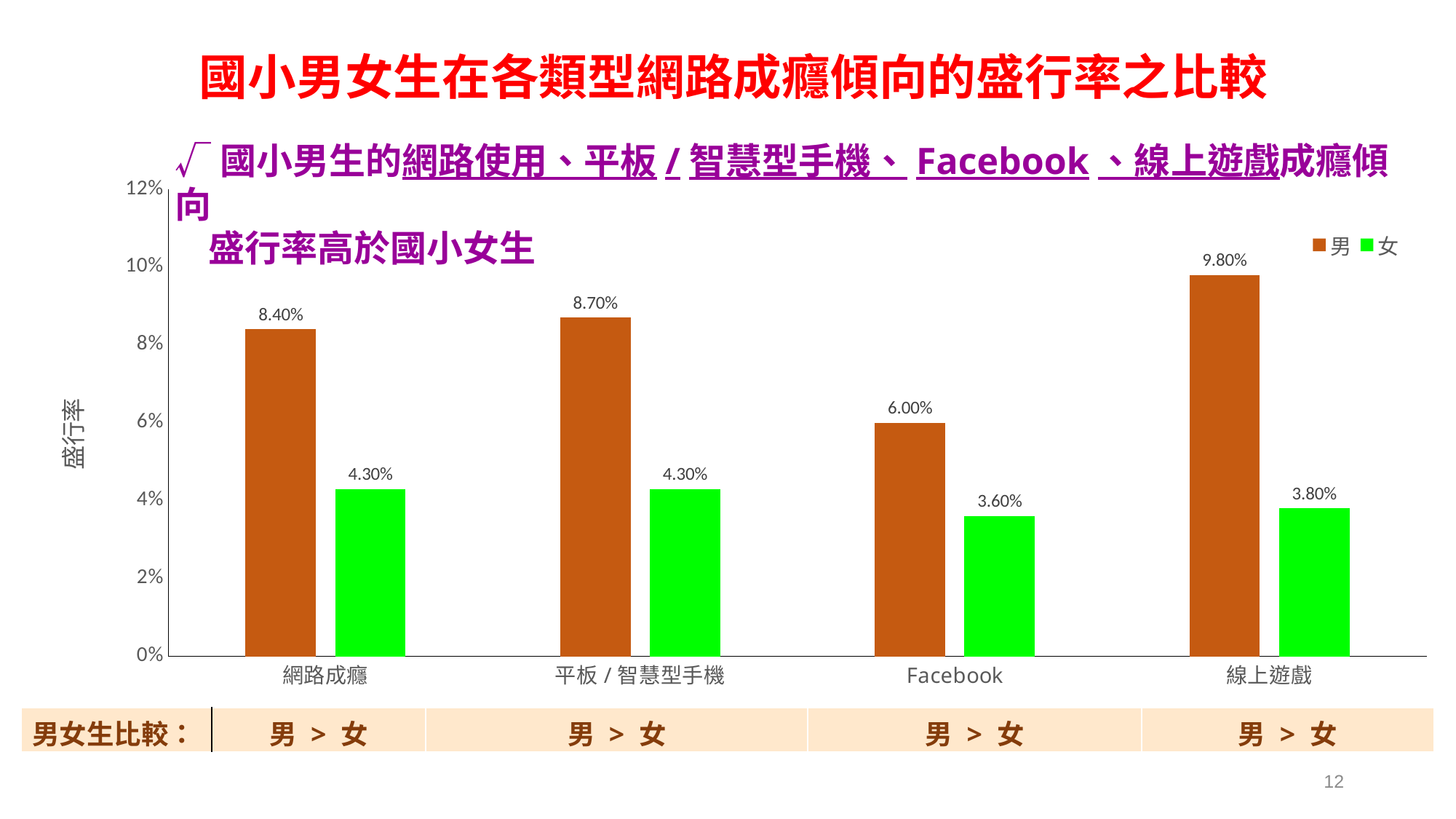
What is the value for 男 in the 線上遊戲 category? 9.80% Which category has the lowest value for 女? Facebook What is the difference between the 男 and 女 values in the 線上遊戲 category? 6.00% How many series does the legend list? 2 Which category has the highest value for 男? 線上遊戲 What is the value for 女 in the 網路成癮 category? 4.30% What kind of chart is shown on the slide? bar chart What is the label of the y axis? 盛行率 What is the value for 男 in the 平板 / 智慧型手機 category? 8.70% How many categories are shown on the x axis? 4 Which is larger in the Facebook category, the value for 男 or for 女? 男 What is the value for 女 in the Facebook category? 3.60%